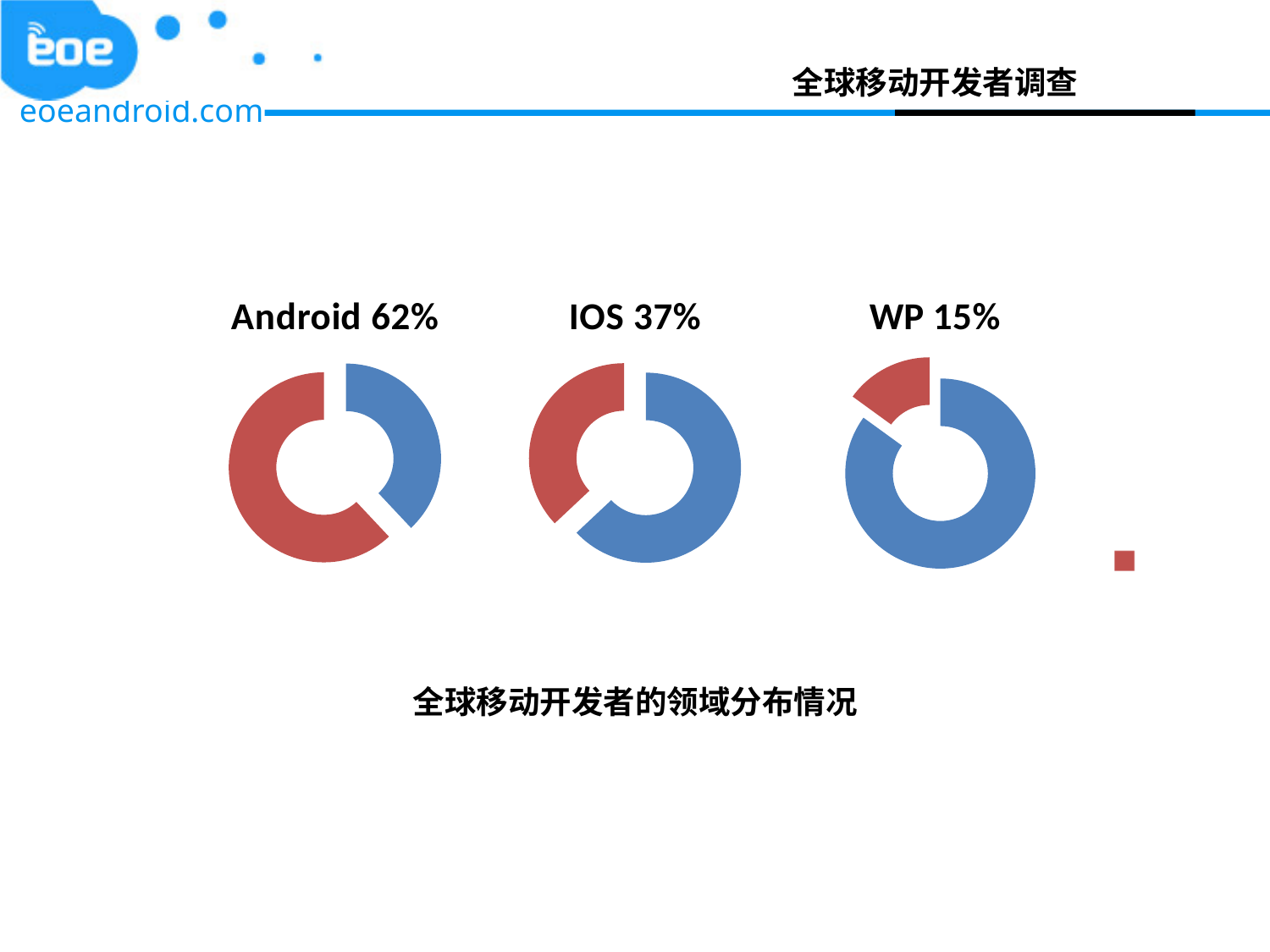
What colour is the slice representing the labelled percentage in each donut chart? Red How many donut charts are shown on the slide? 3 Is the Android percentage greater or less than 50%? greater What is the difference between the IOS percentage and the WP percentage? 22% Which is larger, the IOS percentage or the WP percentage? IOS What percentage is shown for Android on the slide? 62% What percentage is shown for IOS on the slide? 37% What kind of chart is used to show each platform's percentage? Donut (pie) chart What is the difference between the Android percentage and the IOS percentage? 25% Which platform has the lowest percentage among the three donut charts? WP What percentage is shown for WP on the slide? 15% Which platform has the highest percentage among the three donut charts? Android